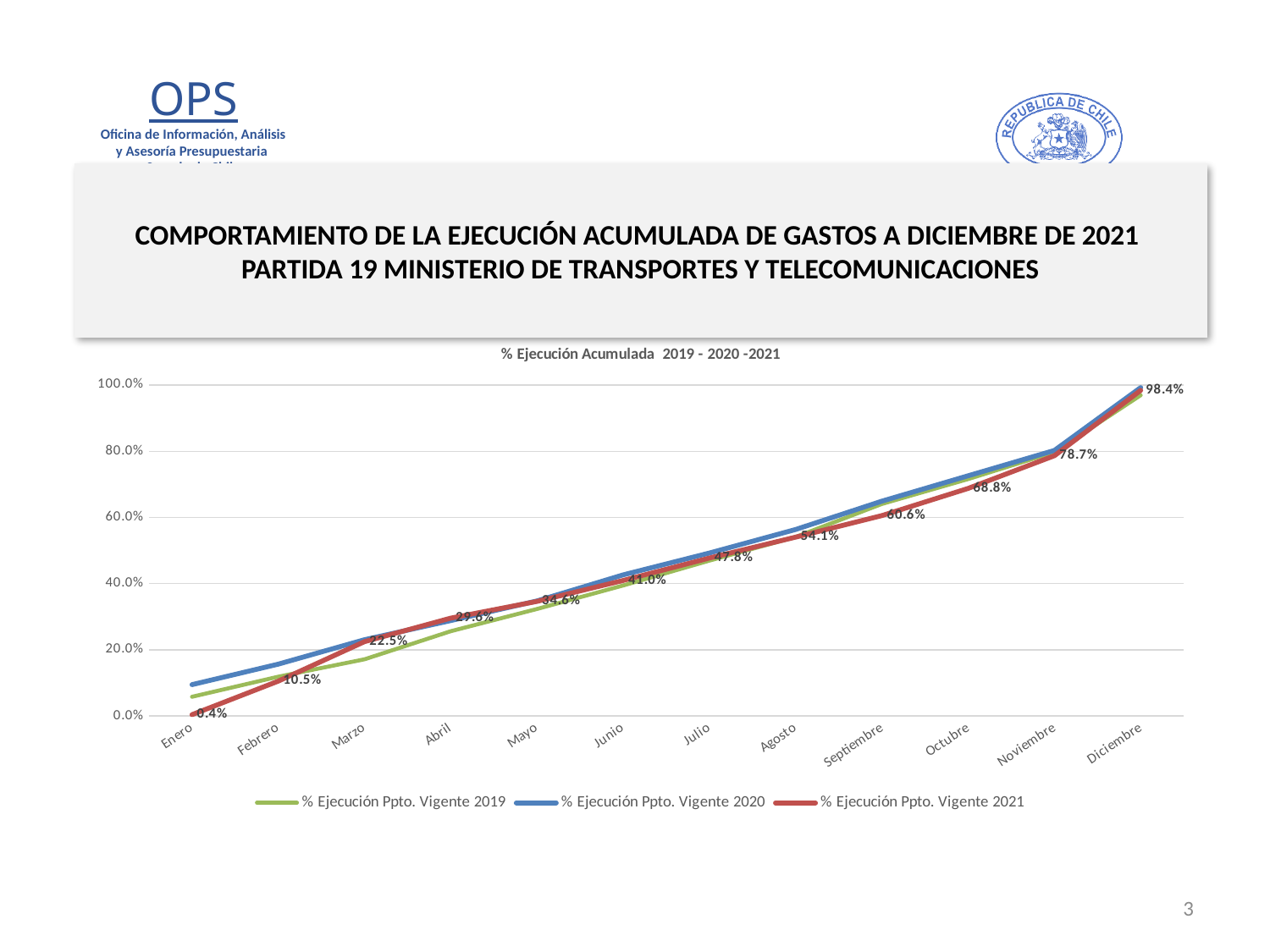
What is the value for % Ejecución Ppto. Vigente 2021 in Junio? 41.0% How many series does the legend list? 3 What is the value for % Ejecución Ppto. Vigente 2021 in Enero? 0.4% Is the value for % Ejecución Ppto. Vigente 2020 in Enero greater or less than 20.0%? less What is the value for % Ejecución Ppto. Vigente 2021 in Septiembre? 60.6% What is the value for % Ejecución Ppto. Vigente 2021 in Diciembre? 98.4% What kind of chart is shown on the slide? Line chart Which month has the lowest value for % Ejecución Ppto. Vigente 2021? Enero What is the difference between the % Ejecución Ppto. Vigente 2021 values for Diciembre and Noviembre? 19.7% In Enero, which series has the larger value: % Ejecución Ppto. Vigente 2020 or % Ejecución Ppto. Vigente 2021? % Ejecución Ppto. Vigente 2020 Which month has the highest value for % Ejecución Ppto. Vigente 2021? Diciembre How many months are shown on the x axis of the chart? 12